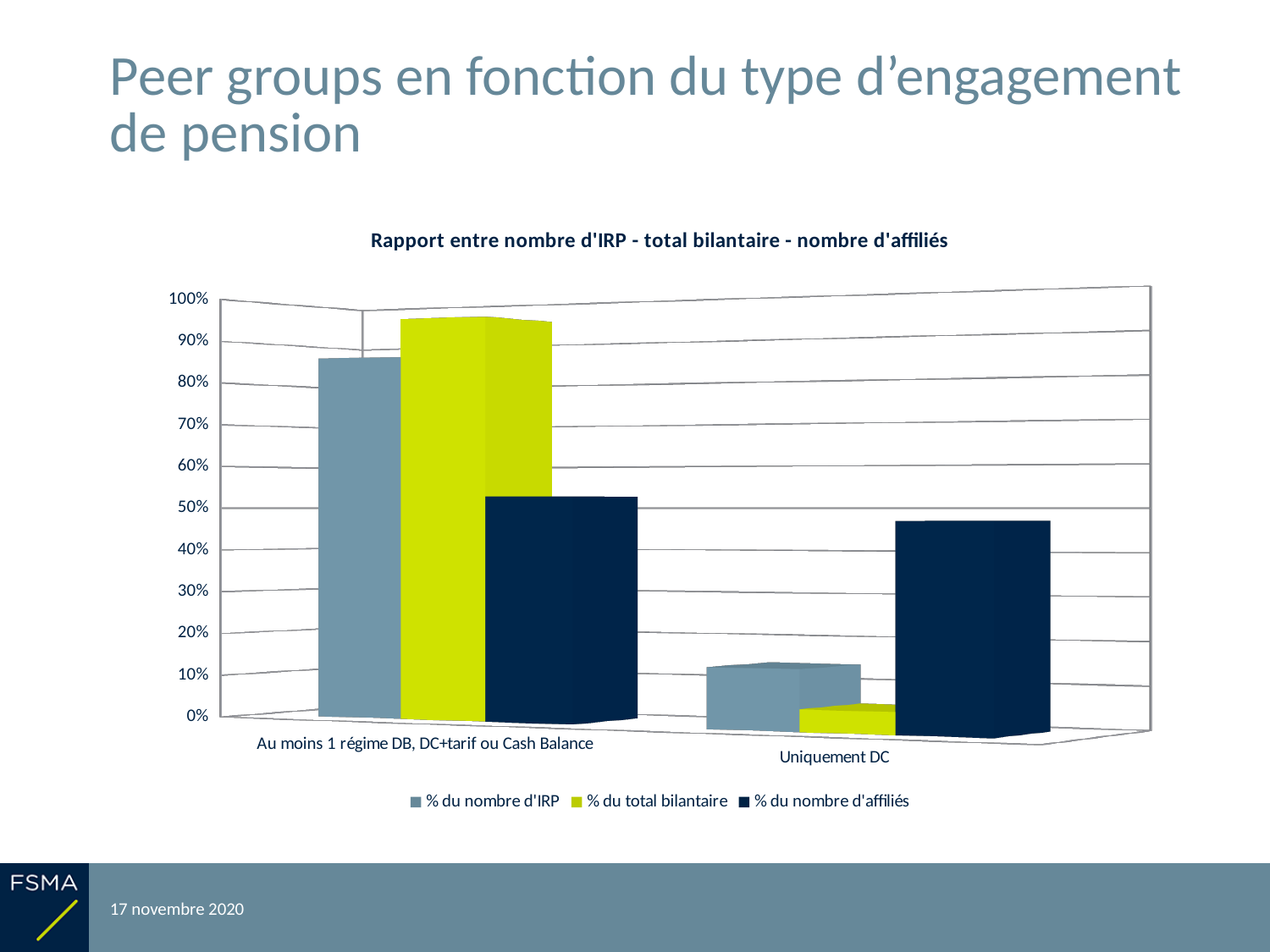
What is the title of the chart? Rapport entre nombre d'IRP - total bilantaire - nombre d'affiliés Is the value of '% du nombre d'IRP' for 'Uniquement DC' greater or less than 20%? less Is the value of '% du nombre d'affiliés' for 'Uniquement DC' greater or less than 30%? greater What kind of chart is shown on the slide? bar chart Which series has the highest value for the category 'Au moins 1 régime DB, DC+tarif ou Cash Balance'? % du total bilantaire How many categories are shown on the x axis? 2 Is the value of '% du total bilantaire' for 'Uniquement DC' greater or less than 10%? less How many series does the legend list? 3 Which series has the lowest value for the category 'Uniquement DC'? % du total bilantaire For 'Uniquement DC', which is larger: '% du nombre d'affiliés' or '% du total bilantaire'? % du nombre d'affiliés